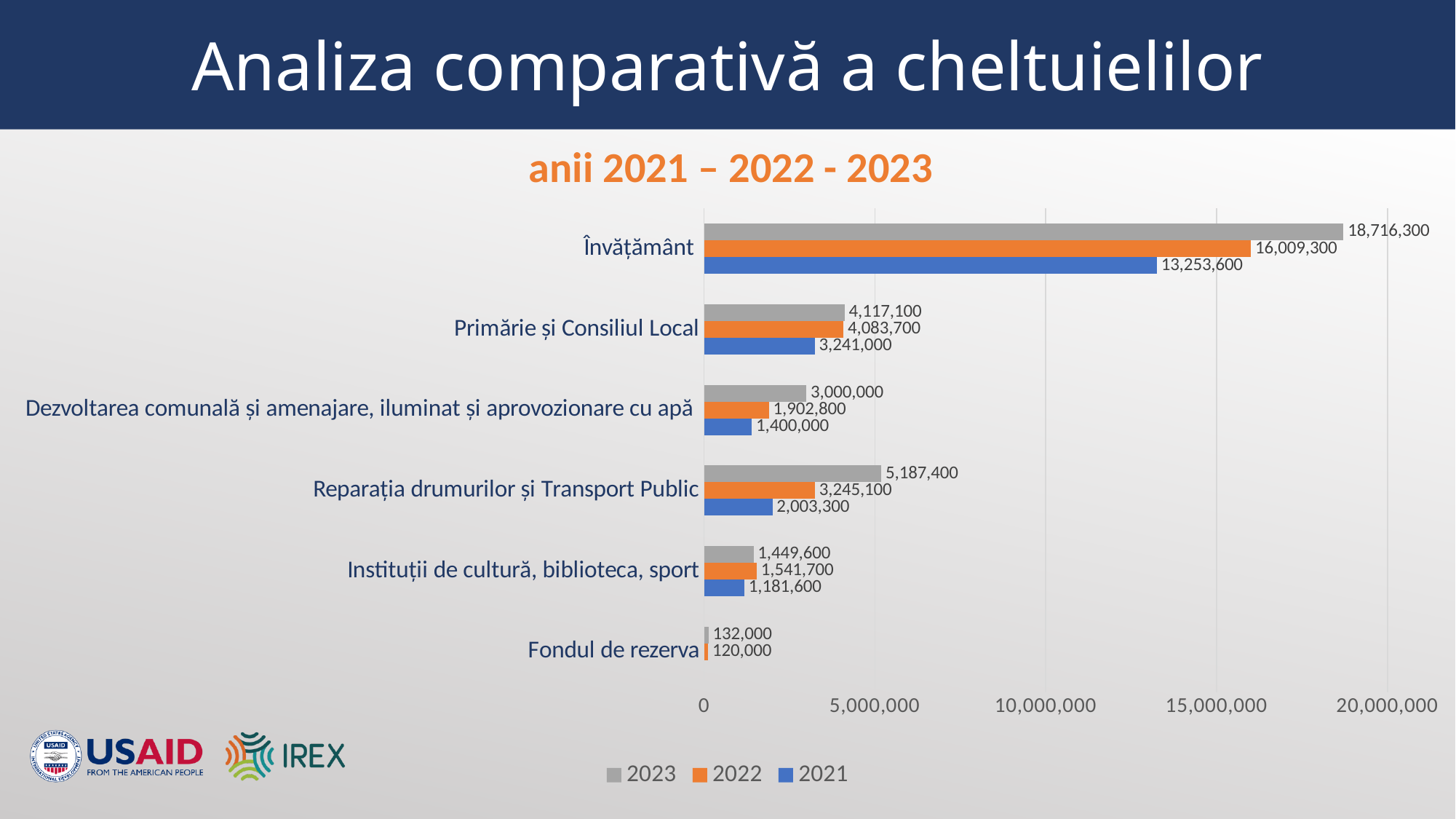
Which category has the lowest value in 2022? Fondul de rezerva What is the value for Instituții de cultură, biblioteca, sport in 2022? 1,541,700 What is the value for Reparația drumurilor și Transport Public in 2021? 2,003,300 What is the difference between the 2023 and 2021 values for Învățământ? 5,462,700 Is the 2023 value for Reparația drumurilor și Transport Public greater or less than 5,000,000? greater How many series does the legend list? 3 What is the value for Învățământ in 2023? 18,716,300 Which category has the highest value in 2023? Învățământ Which is larger for Instituții de cultură, biblioteca, sport: the 2023 value or the 2022 value? 2022 What kind of chart is shown on the slide? bar chart How many categories are shown on the chart? 6 Which colour represents the year 2021 in the chart? blue